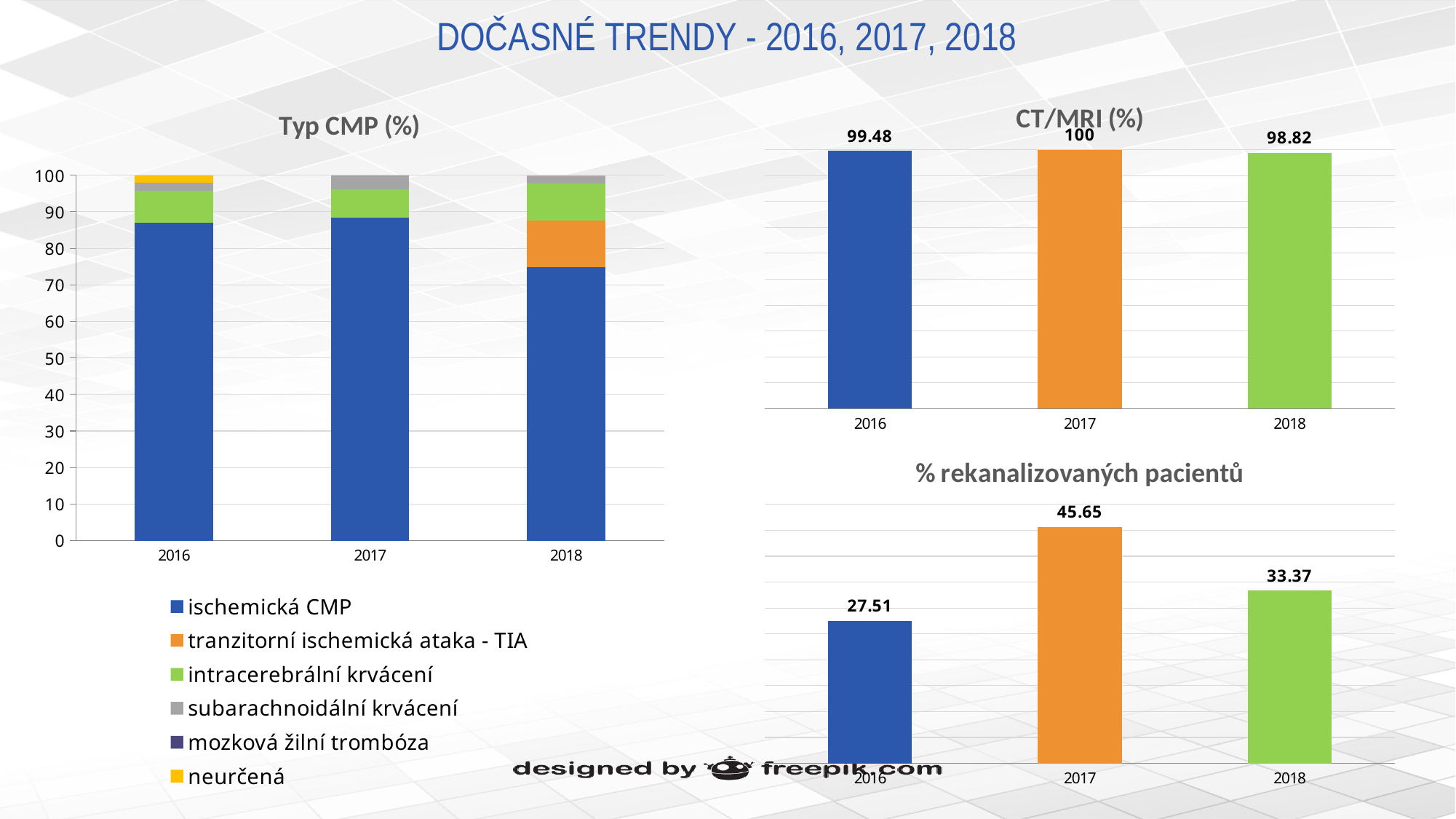
In the '% rekanalizovaných pacientů' chart, what is the difference between the 2017 and 2016 values? 18.14 In the 'Typ CMP (%)' chart, which year has the lowest value for ischemická CMP? 2018 In the 'CT/MRI (%)' chart, what is the difference between the 2016 and 2018 values? 0.66 In the 'Typ CMP (%)' chart, how many series does the legend list? 6 In the 'CT/MRI (%)' chart, which year has the highest value? 2017 In the '% rekanalizovaných pacientů' chart, what is the value for 2017? 45.65 In the '% rekanalizovaných pacientů' chart, which is larger, the value for 2018 or the value for 2016? 2018 In the 'CT/MRI (%)' chart, what is the value for 2018? 98.82 In the 'CT/MRI (%)' chart, what is the value for 2016? 99.48 In the 'Typ CMP (%)' chart, is the value for ischemická CMP in 2018 greater or less than 80? less In the '% rekanalizovaných pacientů' chart, which year has the lowest value? 2016 What kind of chart is the 'Typ CMP (%)' chart? stacked bar chart